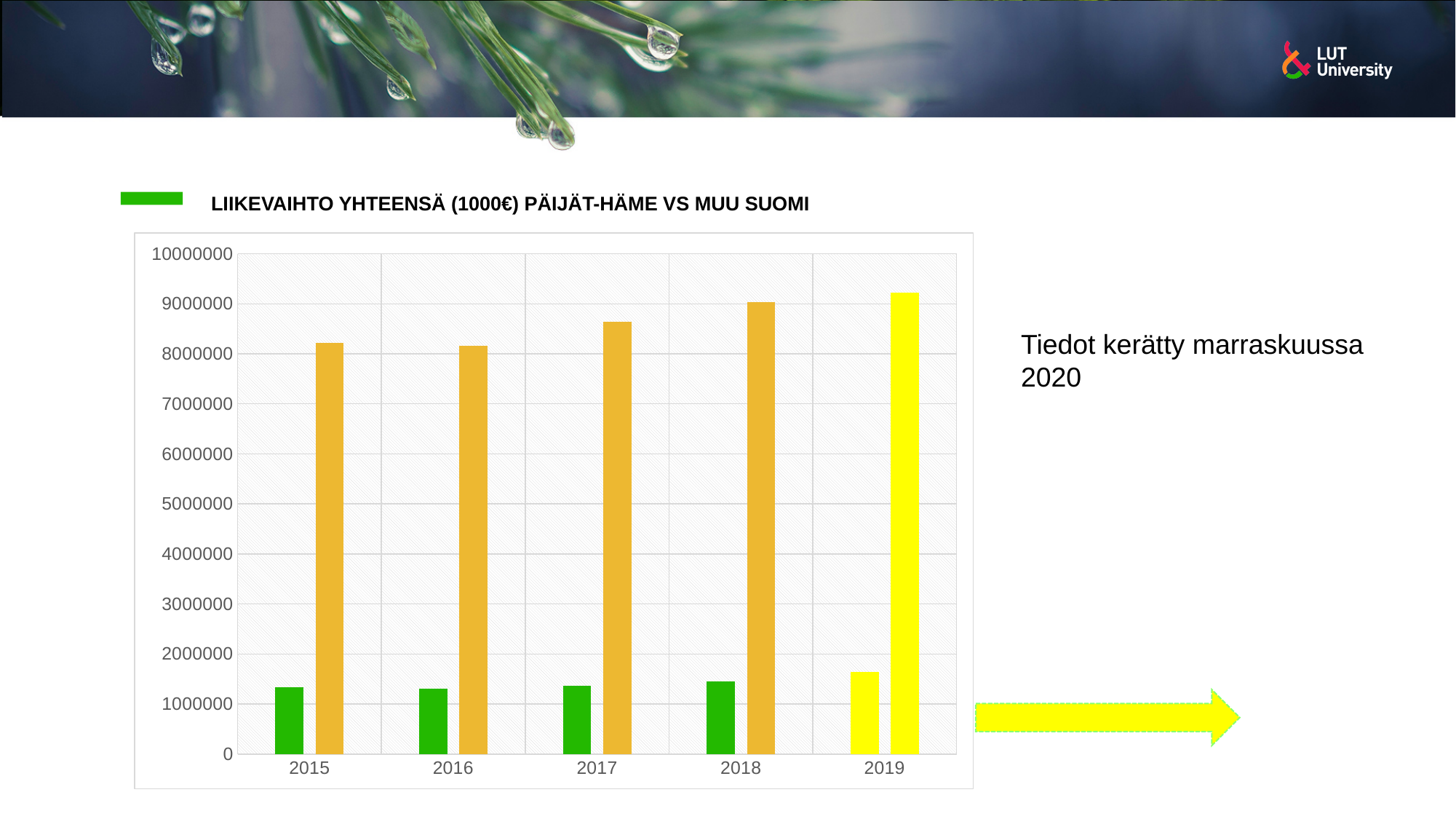
Is the value of the left-hand bar for 2019 greater or less than 2000000? less What is the title of the chart? LIIKEVAIHTO YHTEENSÄ (1000€) PÄIJÄT-HÄME VS MUU SUOMI Is the value of the right-hand bar for 2015 greater or less than 8000000? greater Which is larger in 2018: the left-hand bar or the right-hand bar? the right-hand bar What kind of chart is shown on the slide? bar chart Do the right-hand bars rise or fall from 2016 to 2019? rise In which year is the shorter (left-hand) bar the highest? 2019 Is the value of the left-hand bar for 2015 greater or less than 1000000? greater How many years are shown on the x axis of the chart? 5 In which year is the taller (right-hand) bar the highest? 2019